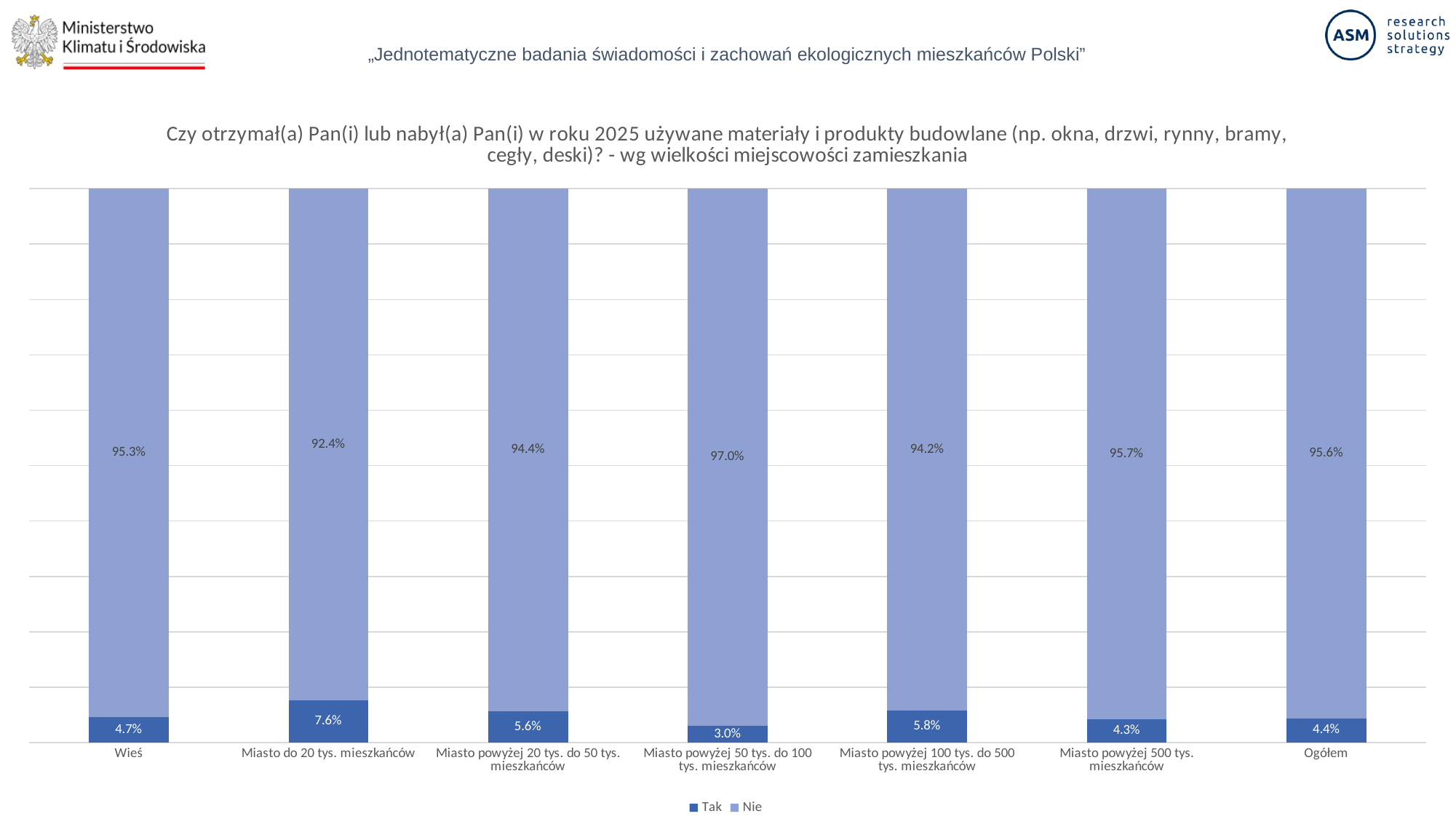
What kind of chart is shown on the slide? Stacked bar chart What is the total of the stacked bar for Miasto powyżej 20 tys. do 50 tys. mieszkańców? 100.0% What is the 'Nie' value for Miasto do 20 tys. mieszkańców? 92.4% What is the difference between the 'Tak' values for Miasto do 20 tys. mieszkańców and Wieś? 2.9% Which is larger: the 'Tak' value for Miasto powyżej 100 tys. do 500 tys. mieszkańców or for Miasto powyżej 500 tys. mieszkańców? Miasto powyżej 100 tys. do 500 tys. mieszkańców What is the 'Nie' value for Miasto powyżej 50 tys. do 100 tys. mieszkańców? 97.0% Which category has the lowest 'Tak' value? Miasto powyżej 50 tys. do 100 tys. mieszkańców What is the 'Tak' value for Ogółem? 4.4% How many categories are shown on the x axis? 7 Which category has the highest 'Tak' value? Miasto do 20 tys. mieszkańców How many series does the legend list? 2 What is the 'Tak' value for Wieś? 4.7%